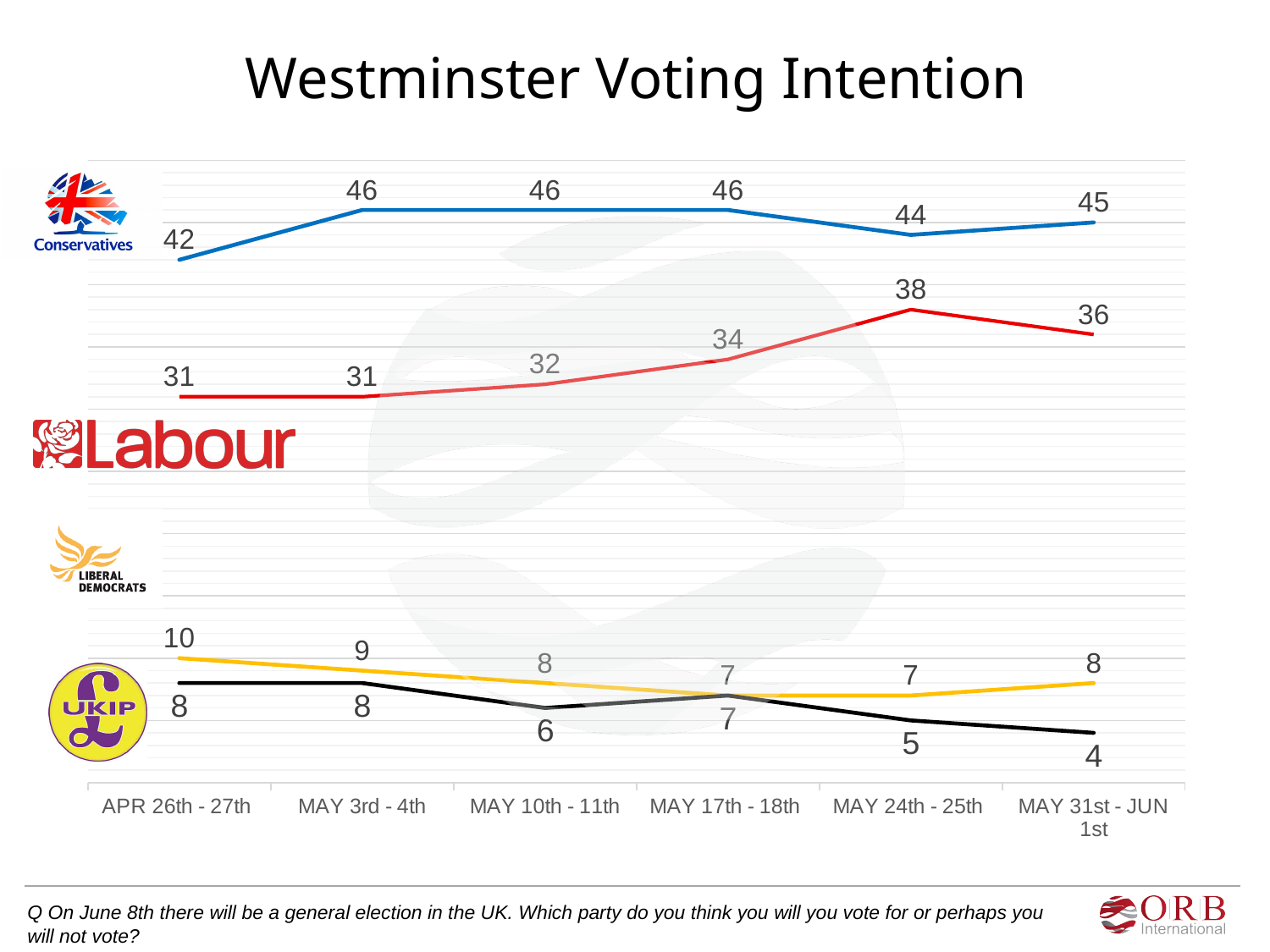
Does UKIP's value rise or fall from MAY 17th - 18th to MAY 31st - JUN 1st? fall What is the Conservatives' value for MAY 24th - 25th? 44 What is the difference between the Conservatives' and Labour's values for MAY 31st - JUN 1st? 9 How many parties are plotted on the chart? 4 What kind of chart is shown on the slide? line chart What is Labour's value for MAY 17th - 18th? 34 How many polling periods are shown on the x axis? 6 In which polling period does Labour reach its highest value? MAY 24th - 25th What is UKIP's value for MAY 31st - JUN 1st? 4 Which party has the higher value for MAY 10th - 11th, the Liberal Democrats or UKIP? Liberal Democrats In which polling period is the Conservatives' value lowest? APR 26th - 27th What is the Liberal Democrats' value for APR 26th - 27th? 10